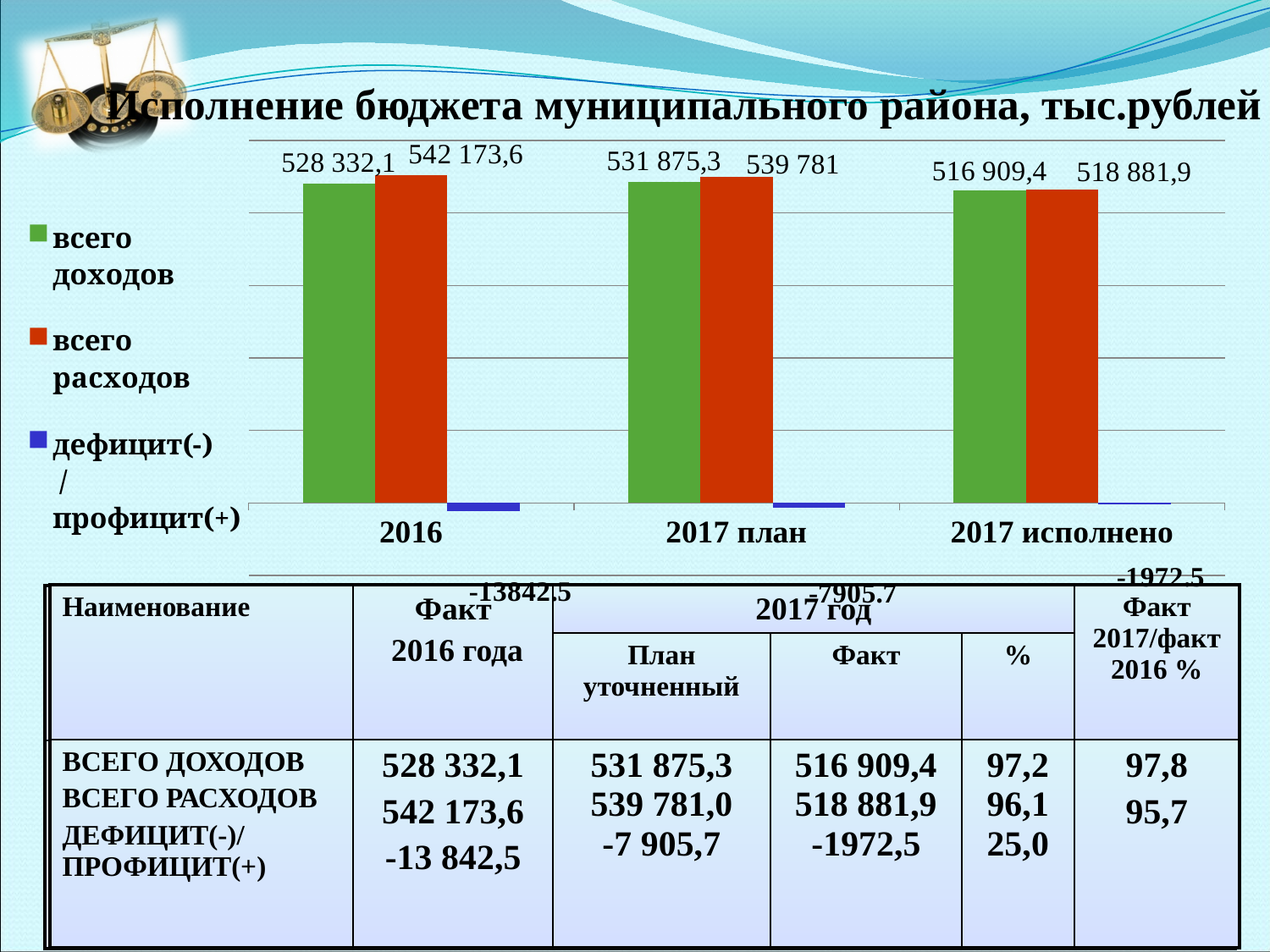
Which is larger for 2016: всего доходов or всего расходов? всего расходов How many series does the chart legend list? 3 What is the value of всего доходов for 2016? 528 332,1 What is the difference between всего расходов and всего доходов for 2017 план? 7 905,7 What kind of chart is shown on the slide? bar chart What is the value of всего доходов for 2017 исполнено? 516 909,4 What is the value of всего расходов for 2017 план? 539 781 What is the value of всего расходов for 2017 исполнено? 518 881,9 Which category has the lowest value for всего доходов? 2017 исполнено How many categories are shown along the x axis of the chart? 3 Do the values for всего расходов rise or fall from 2016 to 2017 исполнено? fall Which category has the highest value for всего расходов? 2016